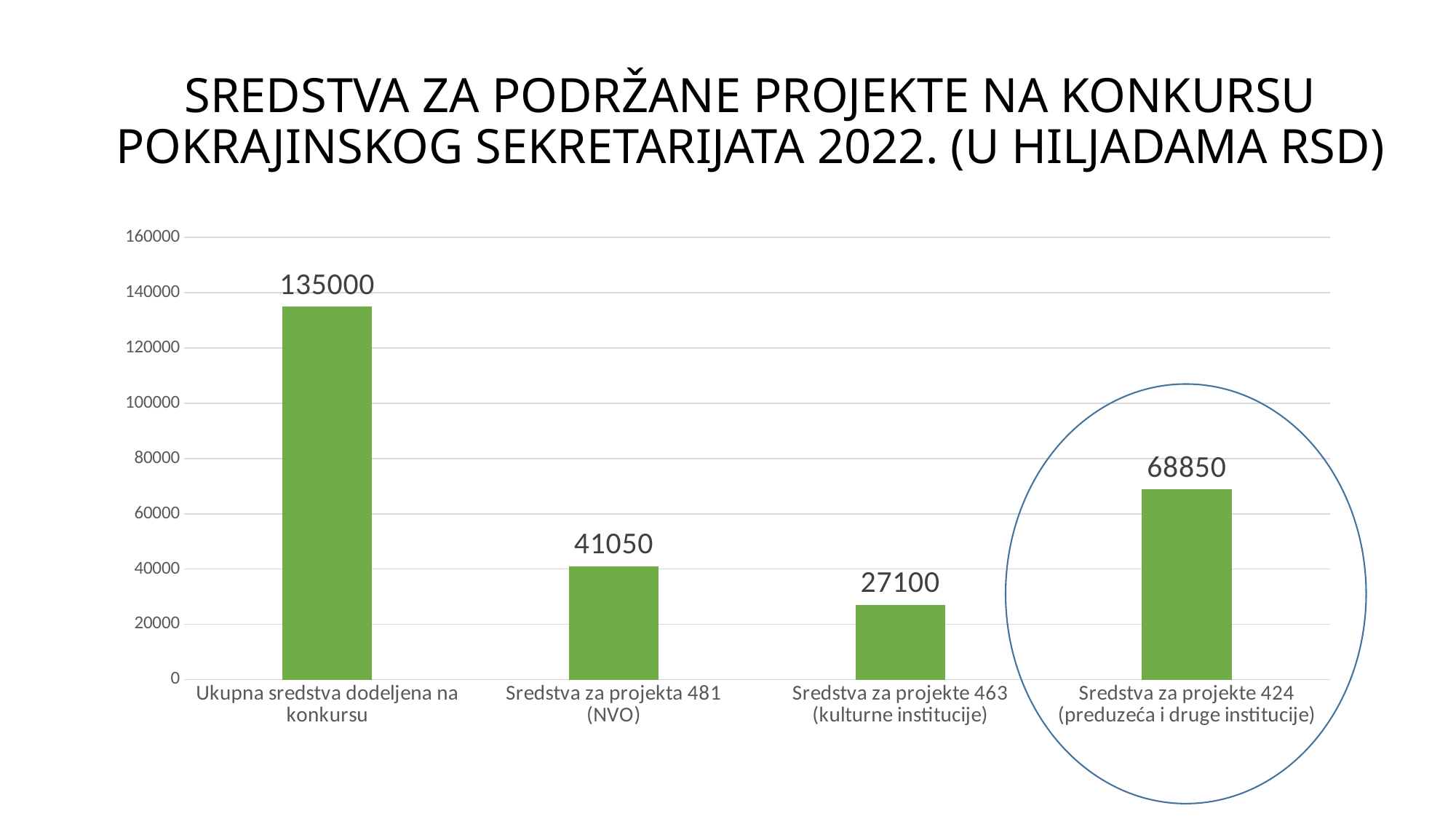
What is the value for "Ukupna sredstva dodeljena na konkursu"? 135000 Which category has the lowest value? Sredstva za projekte 463 (kulturne institucije) What is the value for "Sredstva za projekta 481 (NVO)"? 41050 What is the value for "Sredstva za projekte 463 (kulturne institucije)"? 27100 How many categories are shown on the chart? 4 Is the value for "Sredstva za projekte 424 (preduzeća i druge institucije)" greater or less than 60000? greater What is the value for "Sredstva za projekte 424 (preduzeća i druge institucije)"? 68850 Which is larger: the value for "Sredstva za projekta 481 (NVO)" or for "Sredstva za projekte 463 (kulturne institucije)"? Sredstva za projekta 481 (NVO) Which category has the highest value? Ukupna sredstva dodeljena na konkursu What kind of chart is shown on the slide? bar chart Which category on the chart is circled? Sredstva za projekte 424 (preduzeća i druge institucije) What is the difference between the values for "Sredstva za projekte 424 (preduzeća i druge institucije)" and "Sredstva za projekta 481 (NVO)"? 27800